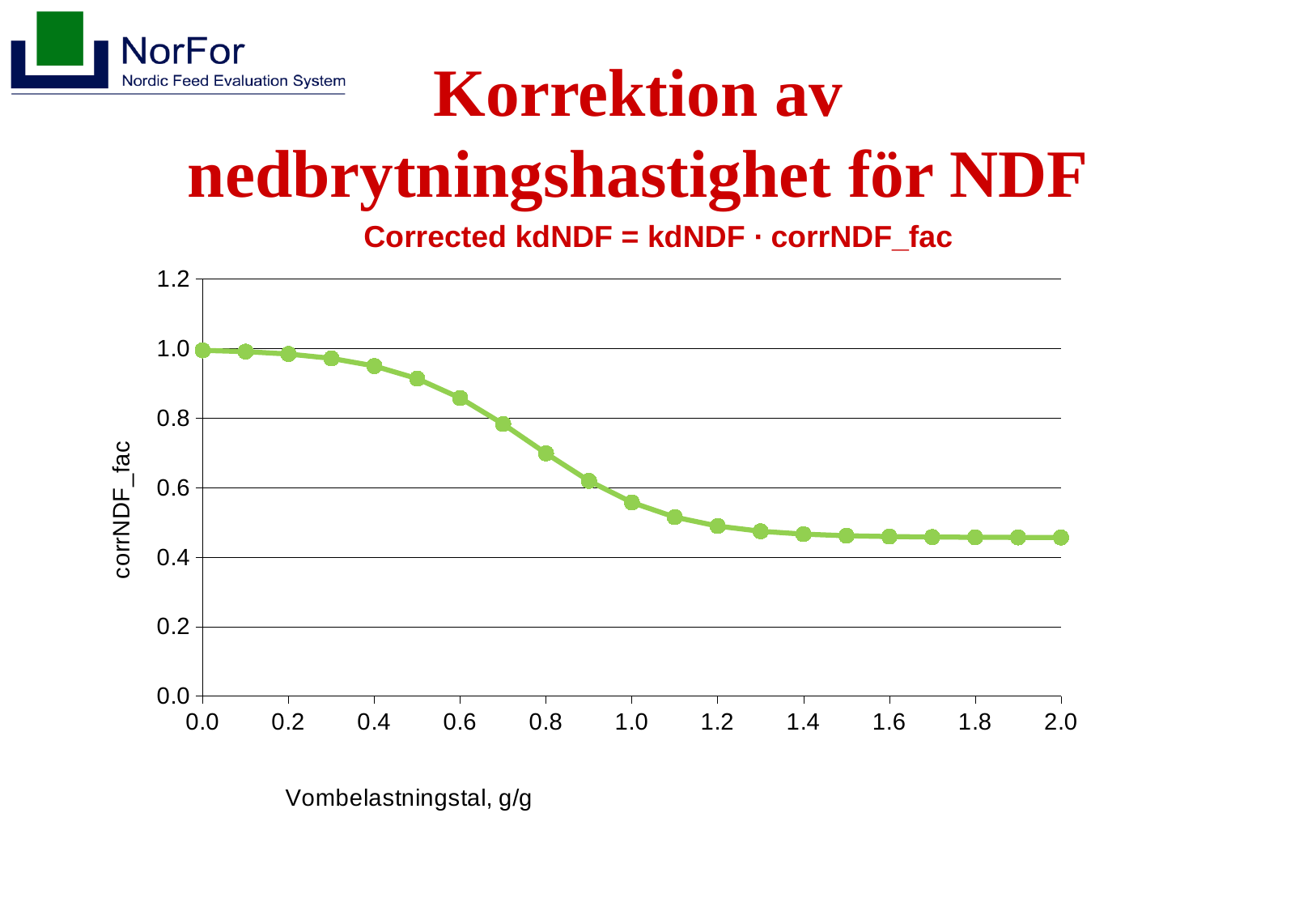
Is the corrNDF_fac value at Vombelastningstal 0.6 greater or less than 0.8? greater What is the label of the y axis? corrNDF_fac How many data points are plotted on the line? 21 What kind of chart is shown on the slide? line chart Is the corrNDF_fac value at Vombelastningstal 1.0 greater or less than 0.8? less Is the corrNDF_fac value at Vombelastningstal 2.0 greater or less than 0.6? less Which has the larger corrNDF_fac value: Vombelastningstal 1.8 or 0.2? 0.2 What is the label of the x axis? Vombelastningstal, g/g Do the corrNDF_fac values rise or fall as Vombelastningstal increases from 0.0 to 2.0? fall Which has the larger corrNDF_fac value: Vombelastningstal 0.4 or 1.2? 0.4